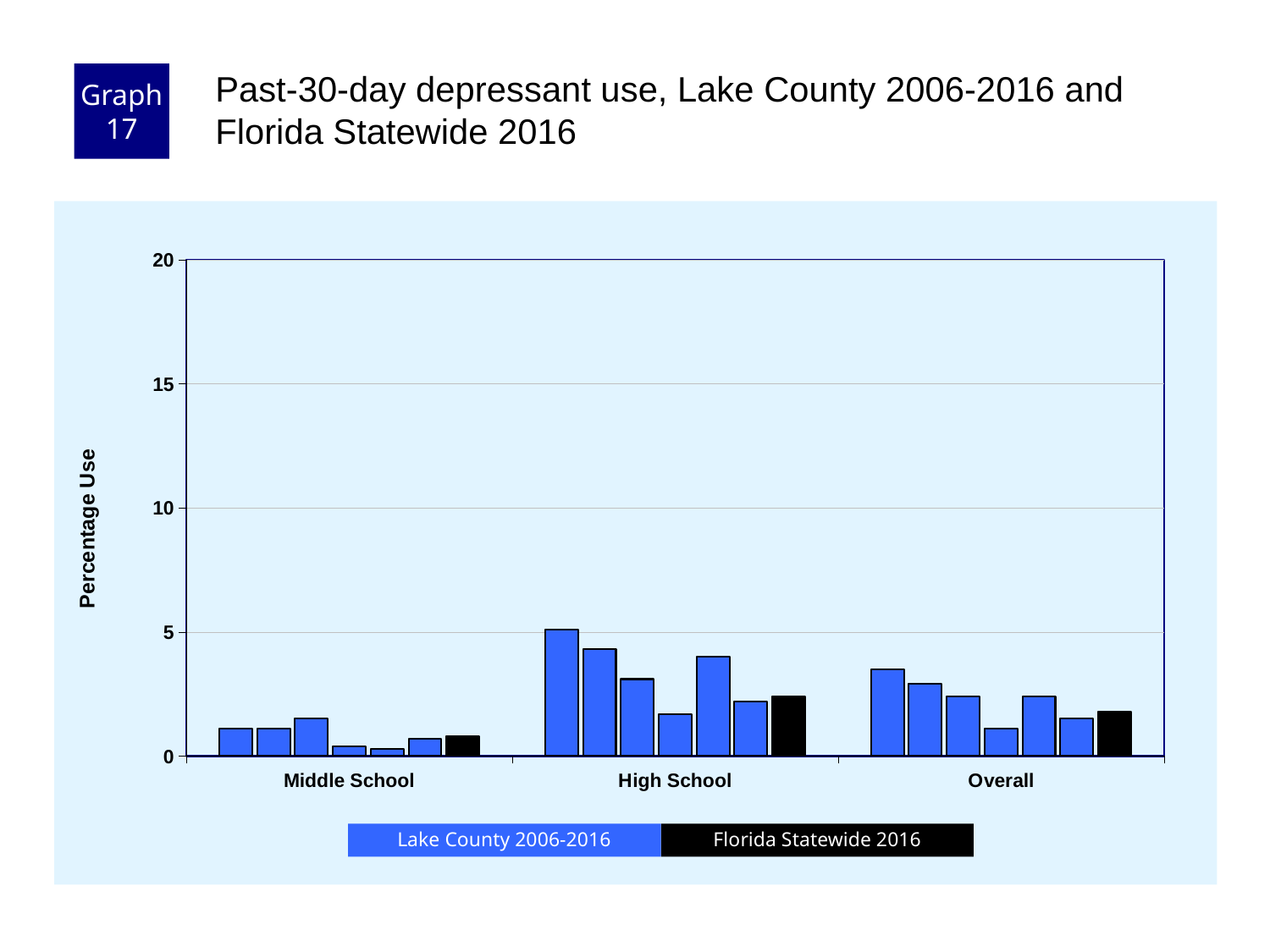
Is the tallest Lake County bar in the Overall group greater or less than 5? less What is the label on the y axis? Percentage Use Is the Florida Statewide 2016 value for Middle School greater or less than 5? less Is the Florida Statewide 2016 value for High School greater or less than 5? less What kind of chart is shown on the slide? bar chart Which colour represents Florida Statewide 2016 in the legend? black How many series does the legend list? 2 How many school-level categories are shown on the x axis? 3 Which category has the lowest Florida Statewide 2016 value? Middle School Which is larger, the Florida Statewide 2016 value for High School or for Middle School? High School Which category has the highest Florida Statewide 2016 value? High School